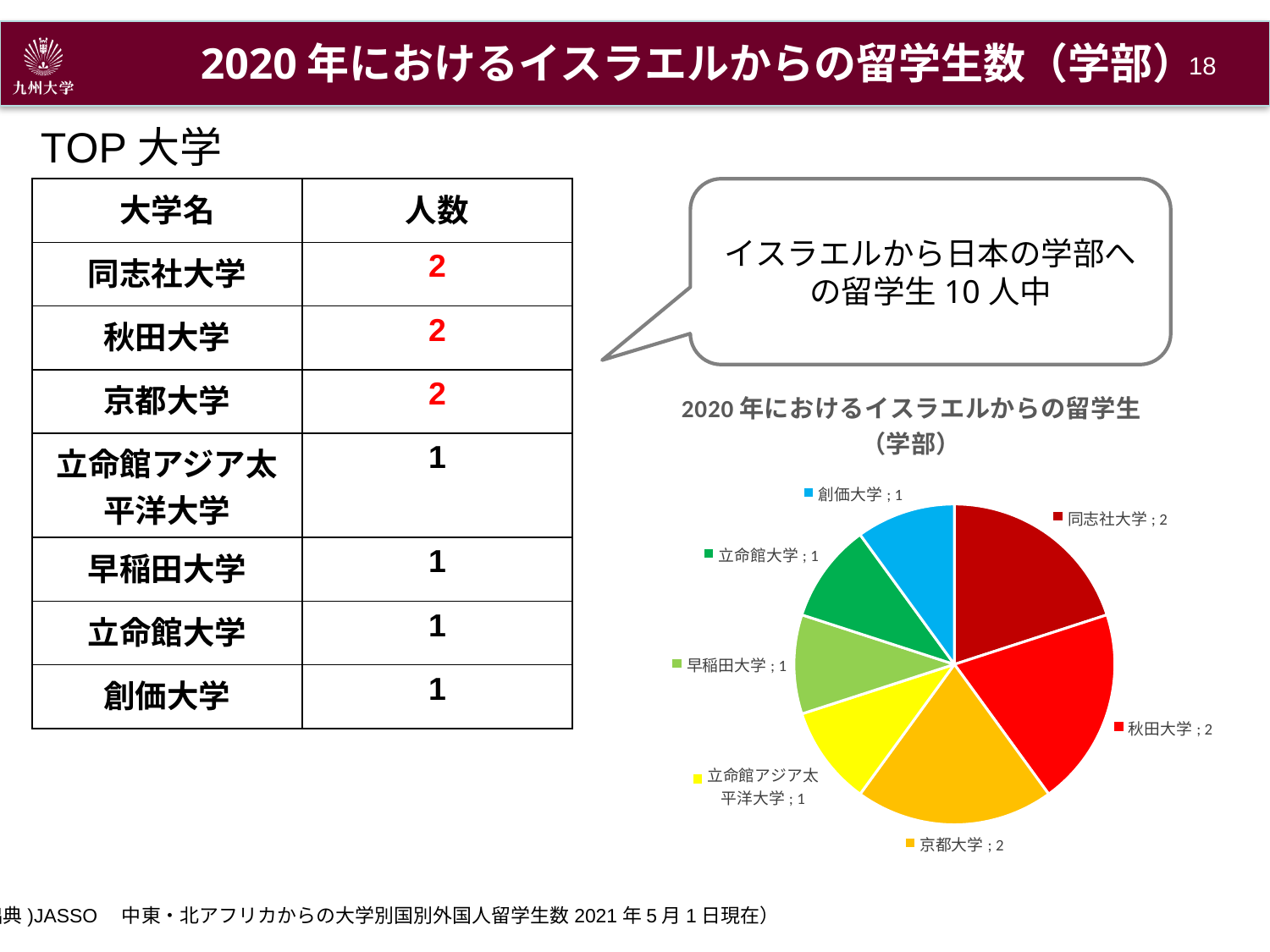
What share of the pie does 秋田大学 represent? 20% What is the title of the pie chart? 2020年におけるイスラエルからの留学生（学部） How many slices does the pie chart have? 7 What is the total of all the values shown in the pie chart? 10 What is the difference between the values for 京都大学 and 立命館アジア太平洋大学? 1 What is the value for 京都大学 in the pie chart? 2 Which is larger, the value for 同志社大学 or the value for 創価大学? 同志社大学 What kind of chart is shown on the slide? pie chart What is the value for 同志社大学 in the pie chart? 2 What is the value for 早稲田大学 in the pie chart? 1 What share of the pie does 立命館大学 represent? 10% What is the value for 創価大学 in the pie chart? 1